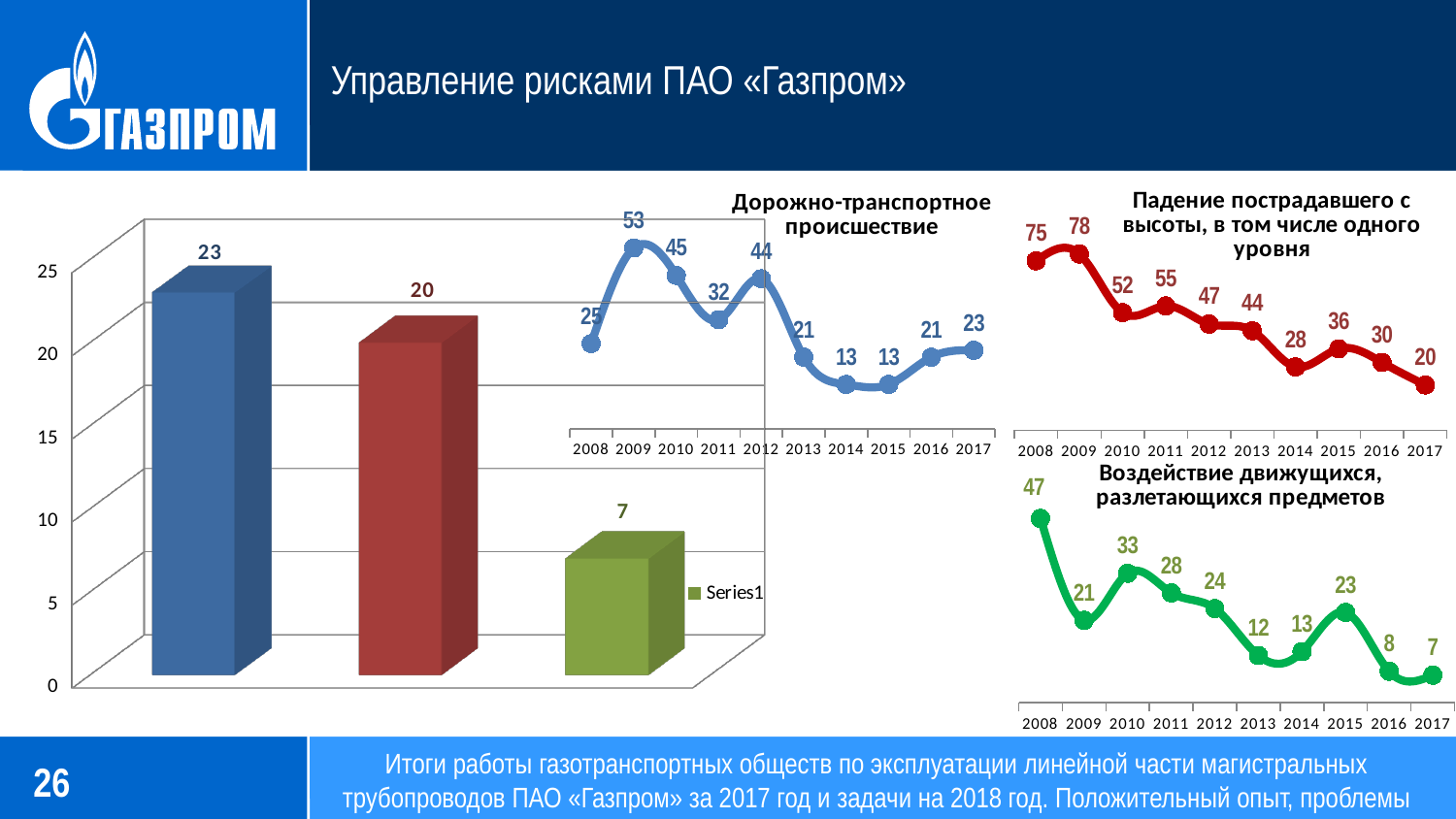
How many years are plotted on the x axis of the line chart titled «Дорожно-транспортное происшествие»? 10 In the line chart titled «Воздействие движущихся, разлетающихся предметов», what is the value for 2015? 23 In the line chart titled «Дорожно-транспортное происшествие», which year has the lowest value? 2014 and 2015 In the line chart titled «Воздействие движущихся, разлетающихся предметов», is the value for 2010 larger or smaller than the value for 2011? larger In the line chart titled «Воздействие движущихся, разлетающихся предметов», do the values generally rise or fall from 2008 to 2017? fall In the line chart titled «Воздействие движущихся, разлетающихся предметов», which year has the lowest value? 2017 In the 3D bar chart on the left of the slide, what is the value of the green bar? 7 What type of chart is the chart on the left of the slide with the legend entry «Series1»? bar chart In the line chart titled «Падение пострадавшего с высоты, в том числе одного уровня», which year has the highest value? 2009 In the line chart titled «Падение пострадавшего с высоты, в том числе одного уровня», what is the value for 2017? 20 In the line chart titled «Дорожно-транспортное происшествие», what is the value for 2009? 53 In the line chart titled «Падение пострадавшего с высоты, в том числе одного уровня», what is the difference between the 2008 value and the 2017 value? 55